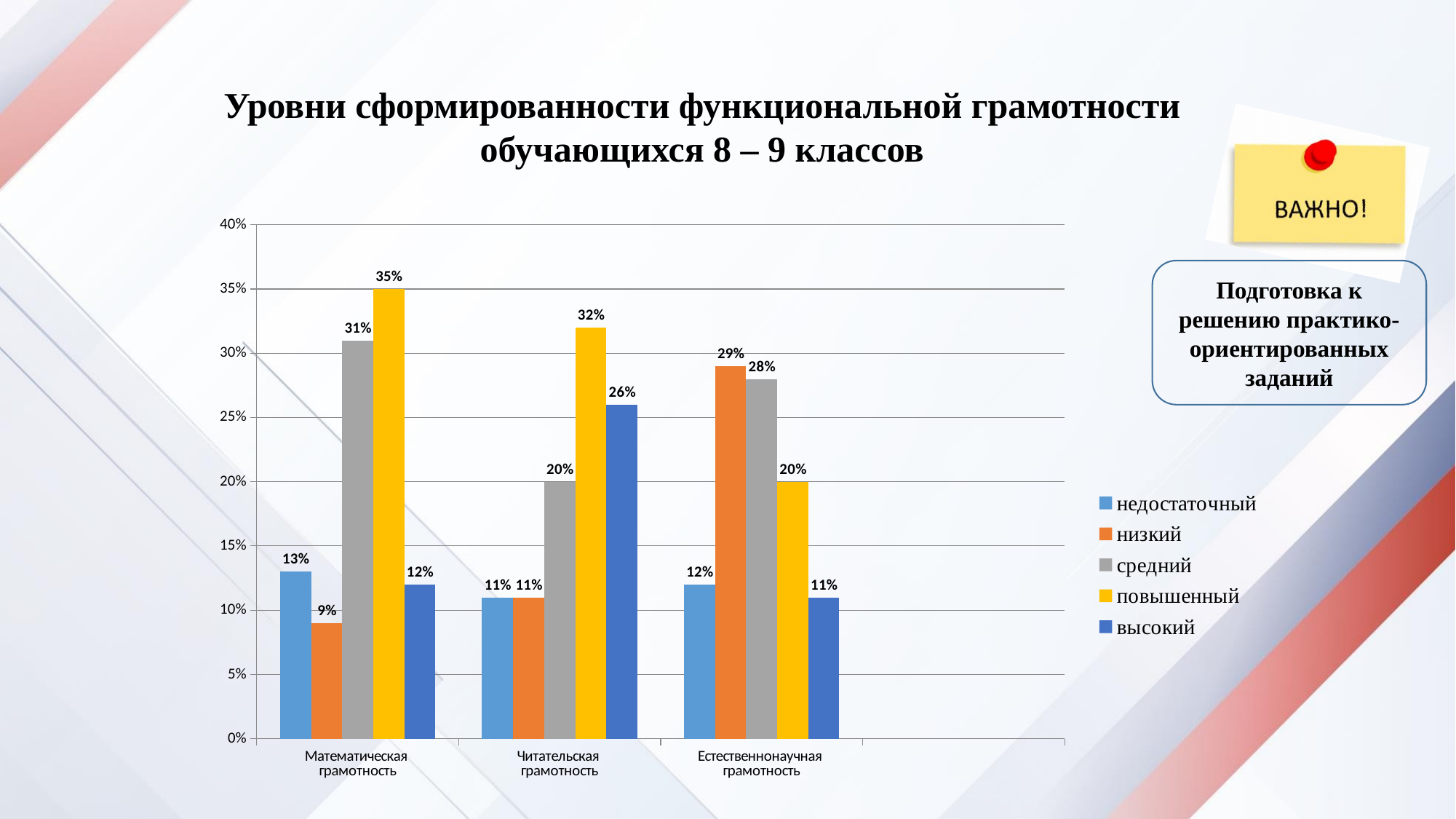
Which level has the lowest value in «Математическая грамотность»? низкий What is the value for «повышенный» in «Математическая грамотность»? 35% What colour represents the «повышенный» series? yellow What is the difference between «повышенный» and «средний» in «Математическая грамотность»? 4% What is the value for «высокий» in «Читательская грамотность»? 26% Is the value for «высокий» in «Читательская грамотность» greater or less than 25%? greater Which is larger in «Естественнонаучная грамотность»: «низкий» or «средний»? низкий How many categories are shown on the x axis? 3 How many series does the legend list? 5 What is the value for «низкий» in «Естественнонаучная грамотность»? 29% Which level has the highest value in «Читательская грамотность»? повышенный What kind of chart is shown on the slide? bar chart